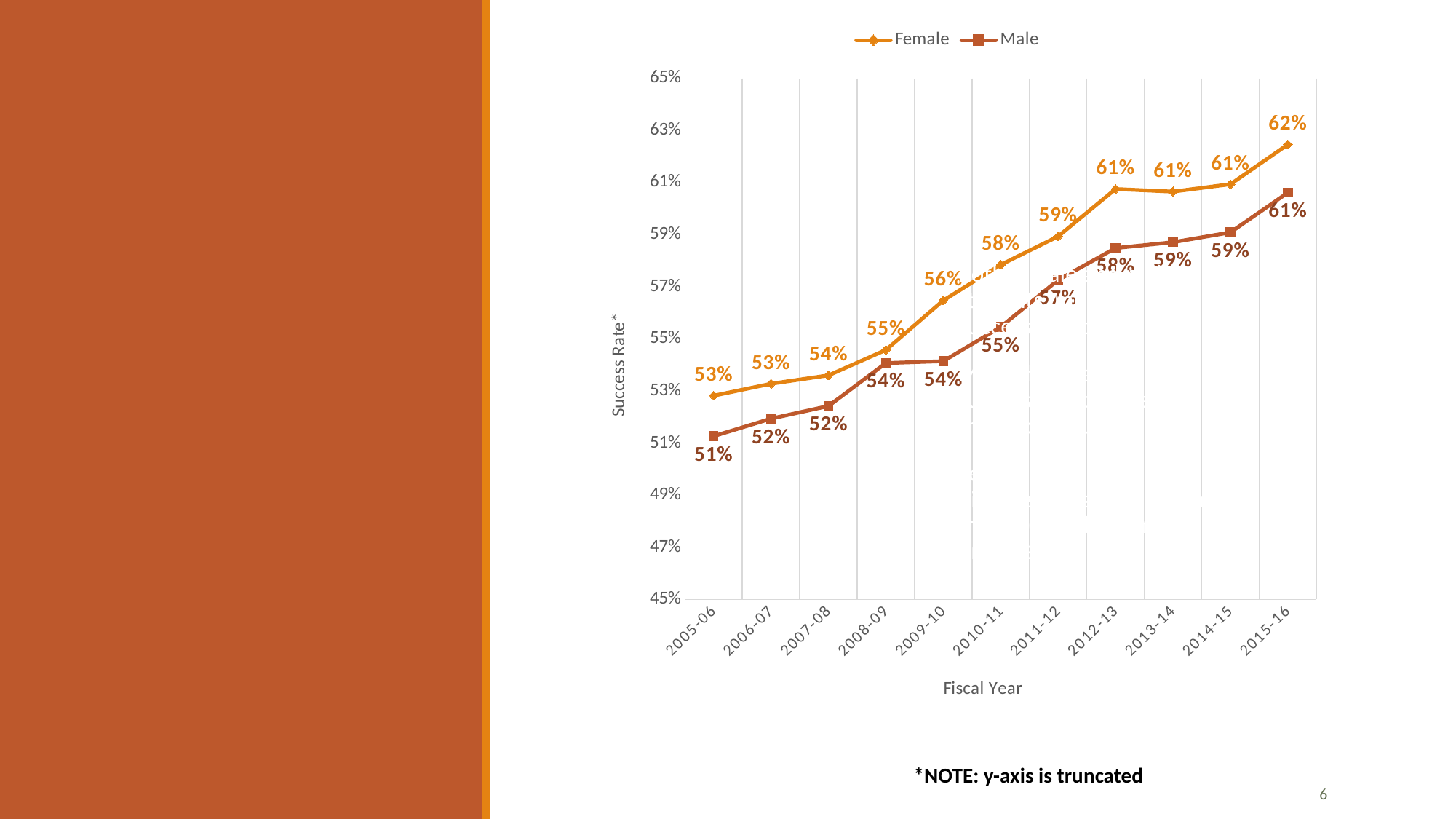
What is the difference between the Female and Male success rates in 2010-11? 3% Do the Male success rates generally rise or fall from 2005-06 to 2015-16? rise In which fiscal year is the Female success rate highest? 2015-16 In which fiscal year is the Male success rate lowest? 2005-06 What type of chart is shown on the slide? line chart What is the Male success rate in 2011-12? 57% What is the Male success rate in 2005-06? 51% How many fiscal years are plotted on the x axis? 11 Which series has the higher success rate in 2012-13, Female or Male? Female What is the Female success rate in 2015-16? 62% What is the Female success rate in 2009-10? 56% How many series does the legend list? 2